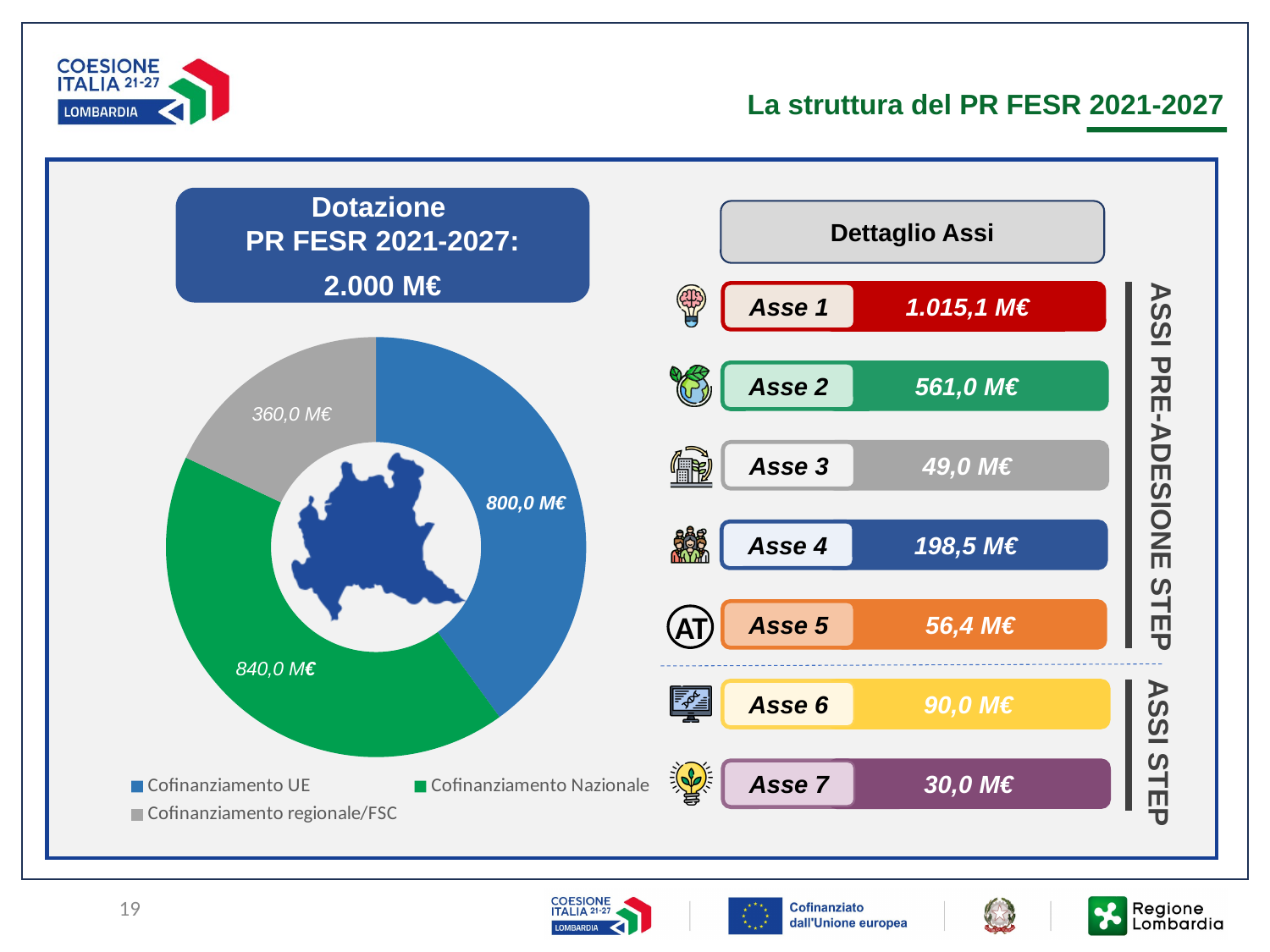
What is the difference between Cofinanziamento UE and Cofinanziamento regionale/FSC in the doughnut chart? 440,0 M€ What is the difference between Cofinanziamento Nazionale and Cofinanziamento UE in the doughnut chart? 40,0 M€ How many categories does the doughnut chart show? 3 Which category has the smallest slice in the doughnut chart? Cofinanziamento regionale/FSC What share of the total 2.000 M€ does Cofinanziamento UE represent in the doughnut chart? 40% Which colour represents Cofinanziamento Nazionale in the doughnut chart? Green What is the value for Cofinanziamento Nazionale in the doughnut chart? 840,0 M€ What is the value for Cofinanziamento UE in the doughnut chart? 800,0 M€ Which is larger in the doughnut chart: Cofinanziamento UE or Cofinanziamento regionale/FSC? Cofinanziamento UE What kind of chart is shown on the left of the slide? Doughnut chart Which category has the largest slice in the doughnut chart? Cofinanziamento Nazionale What is the value for Cofinanziamento regionale/FSC in the doughnut chart? 360,0 M€